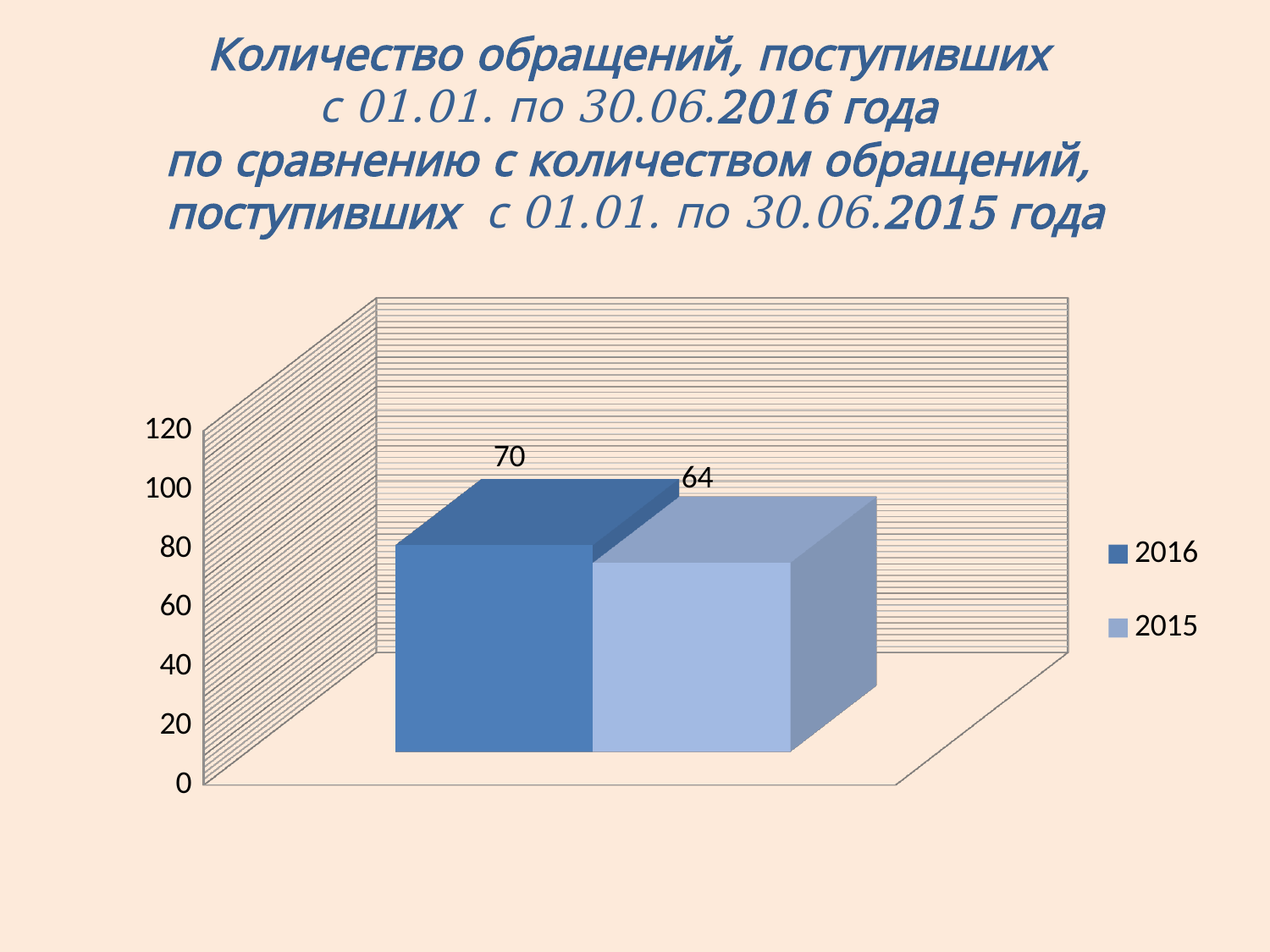
Is the value for 2016 greater or less than 60? greater What kind of chart is shown on the slide? Bar chart Is the value for 2015 greater or less than 80? less Which legend entry is shown in the darker blue colour? 2016 What is the difference between the values for 2016 and 2015? 6 Which series has the higher value, 2016 or 2015? 2016 What is the value for 2016? 70 Which series has the lower value? 2015 How many series does the legend list? 2 What is the value for 2015? 64 Is the value for 2016 larger than the value for 2015? Yes What is the highest value shown on the vertical axis? 120